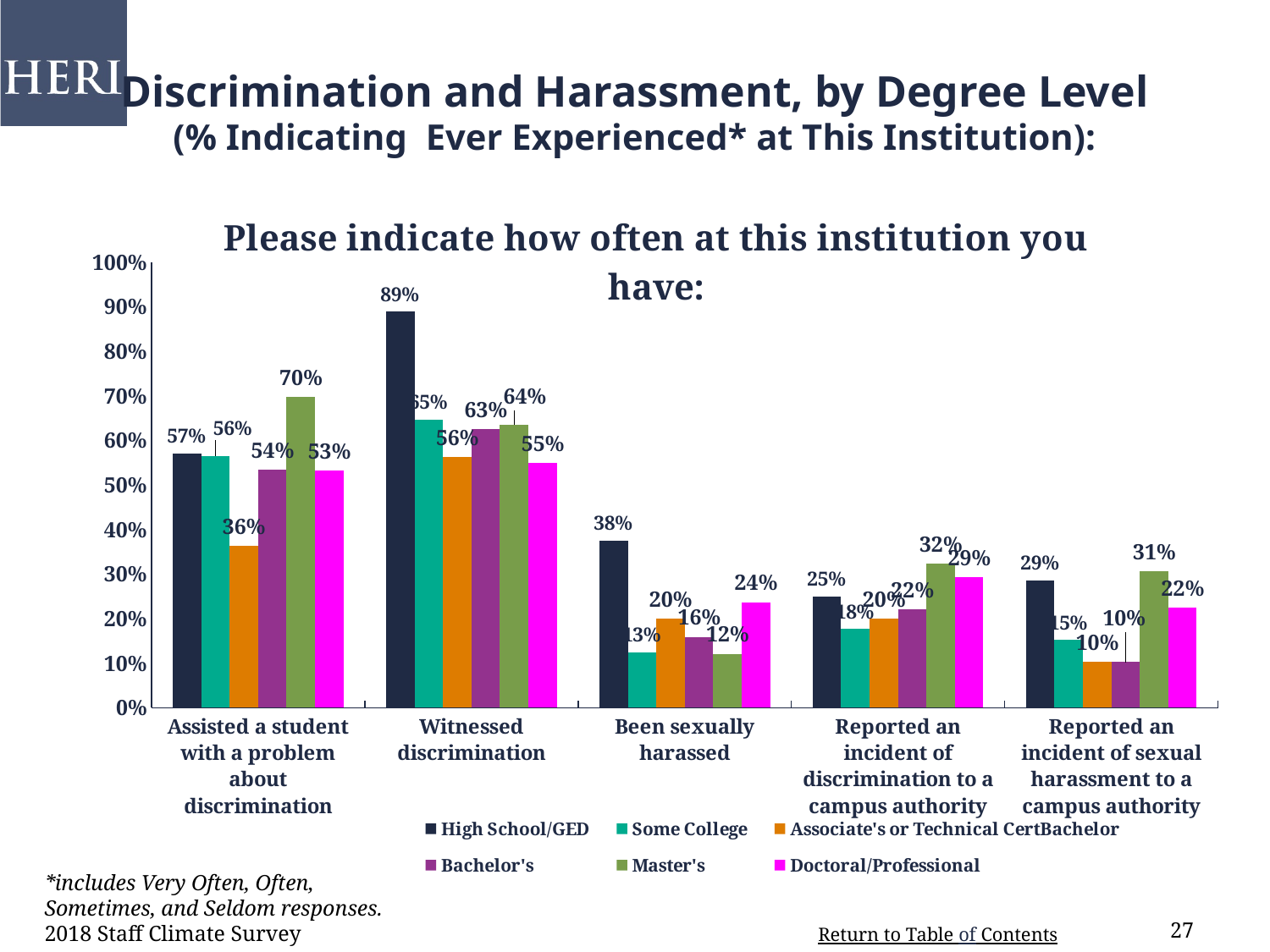
What percentage of High School/GED staff indicated they had witnessed discrimination? 89% What is the value for Master's in the 'Assisted a student with a problem about discrimination' category? 70% How many series does the chart's legend list? 6 How many categories are shown on the x axis of the chart? 5 Is the Master's value for 'Reported an incident of sexual harassment to a campus authority' greater or less than 20%? greater Which degree level has the lowest value for 'Assisted a student with a problem about discrimination'? Associate's or Technical Cert What is the difference between the High School/GED and Doctoral/Professional values for 'Witnessed discrimination'? 34% Which degree level has the highest value for 'Witnessed discrimination'? High School/GED What percentage of Doctoral/Professional staff reported having been sexually harassed? 24% What type of chart is shown on the slide? Bar chart For 'Reported an incident of discrimination to a campus authority', which is larger: the Master's value or the High School/GED value? Master's What is the value for Associate's or Technical Cert in the 'Assisted a student with a problem about discrimination' category? 36%